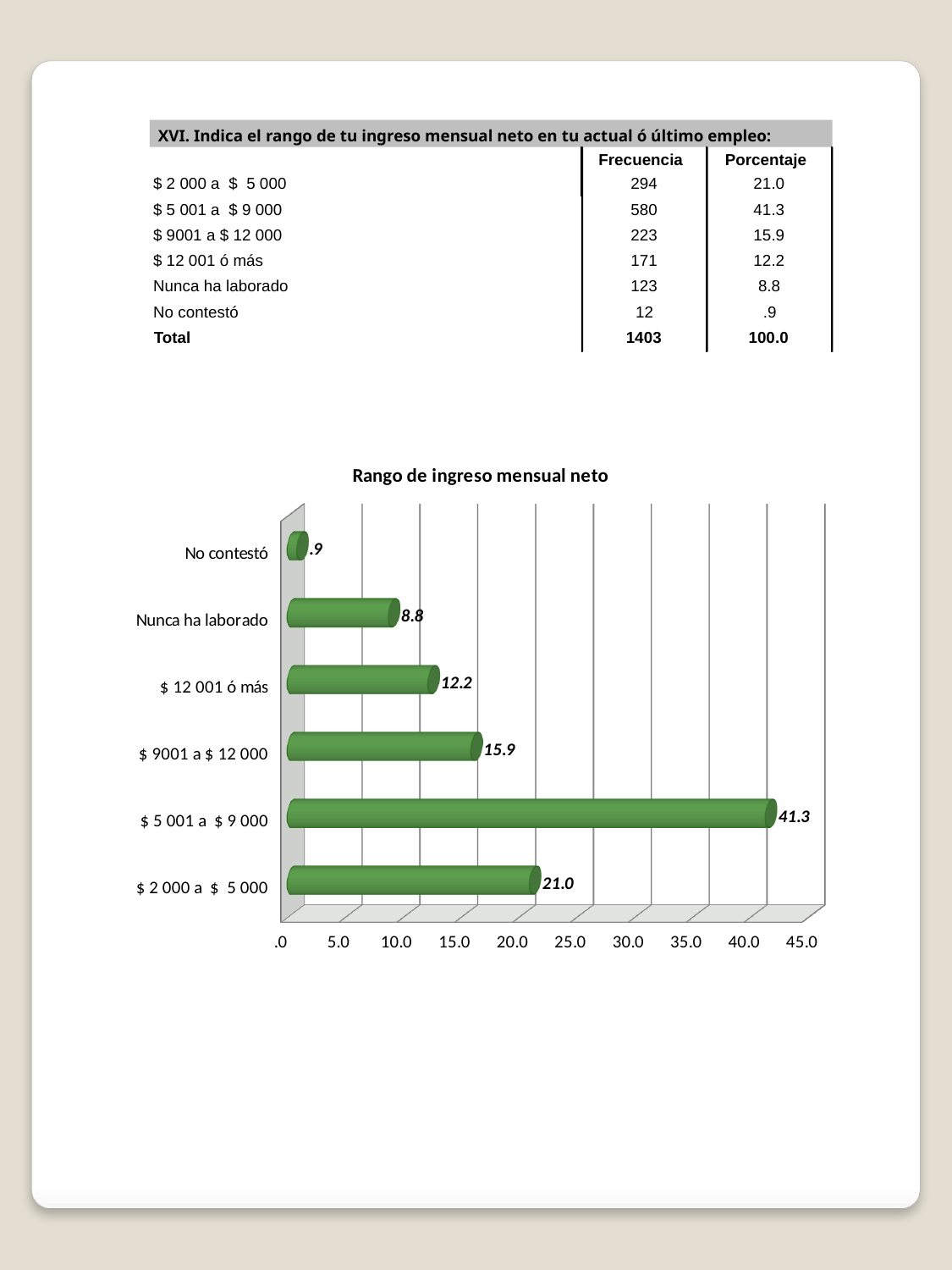
What is the value for "Nunca ha laborado" in the chart? 8.8 What is the value for "No contestó" in the chart? .9 Which category has the lowest value in the chart? No contestó Which is larger, the value for "$ 2 000 a $ 5 000" or the value for "$ 9001 a $ 12 000"? $ 2 000 a $ 5 000 What is the difference between the values for "$ 5 001 a $ 9 000" and "$ 2 000 a $ 5 000"? 20.3 What is the value for "$ 5 001 a $ 9 000" in the chart? 41.3 What is the title of the chart? Rango de ingreso mensual neto What is the difference between the values for "$ 9001 a $ 12 000" and "$ 12 001 ó más"? 3.7 Which category has the highest value in the chart? $ 5 001 a $ 9 000 Is the value for "$ 12 001 ó más" greater or less than 15.0? less What kind of chart is shown on the slide? bar chart How many categories are shown in the chart? 6